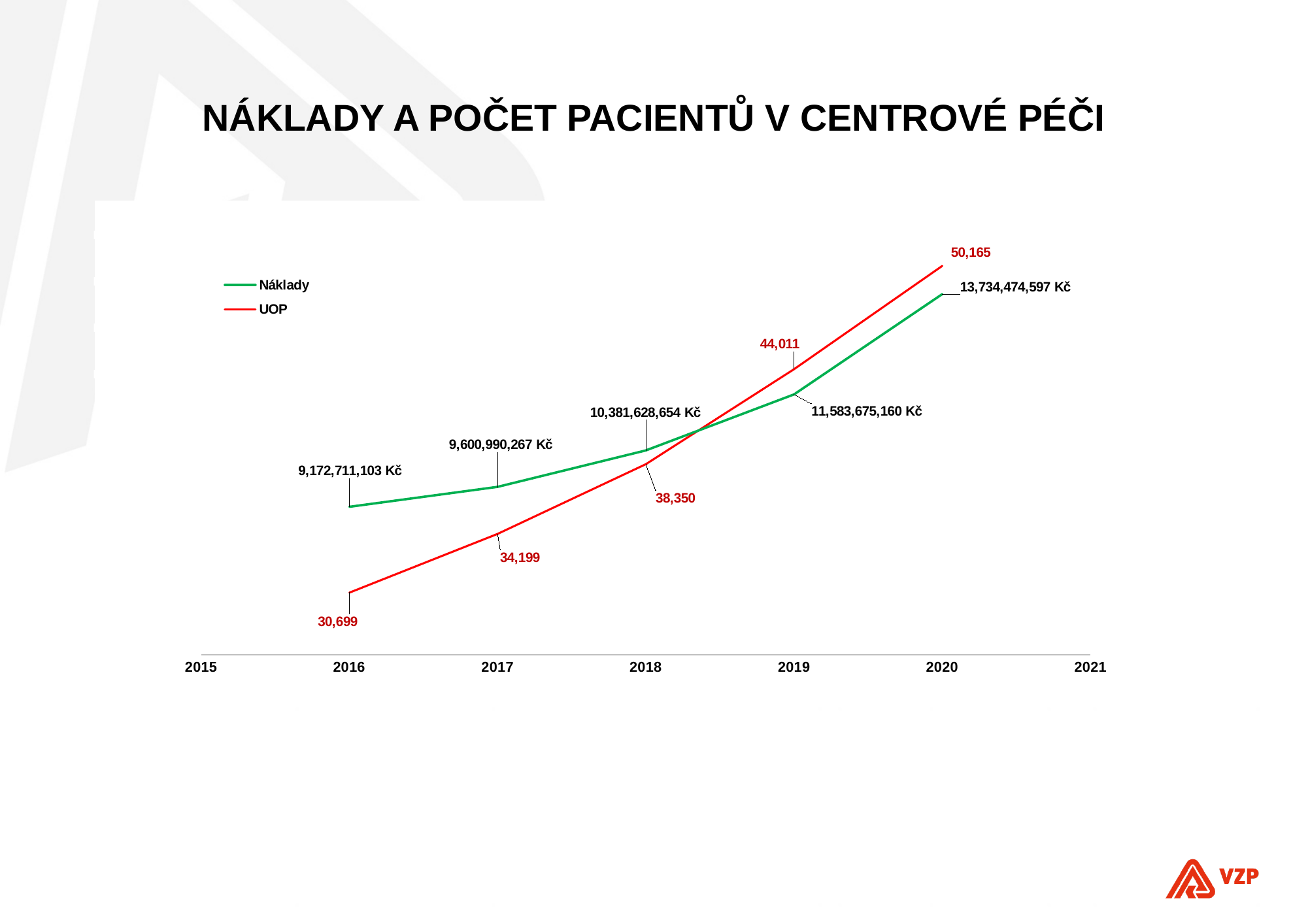
What is the difference between Náklady in 2020 and Náklady in 2019? 2,150,799,437 Kč Does the UOP series rise or fall from 2016 to 2020? rise What is the difference between UOP in 2020 and UOP in 2016? 19,466 What type of chart is shown on the slide? line chart What is the value of Náklady in 2020? 13,734,474,597 Kč In which year is UOP highest? 2020 How many series does the legend list? 2 What is the value of Náklady in 2016? 9,172,711,103 Kč What is the value of UOP in 2017? 34,199 What is the value of UOP in 2018? 38,350 In which year is Náklady lowest? 2016 How many data points are labelled for the Náklady series? 5